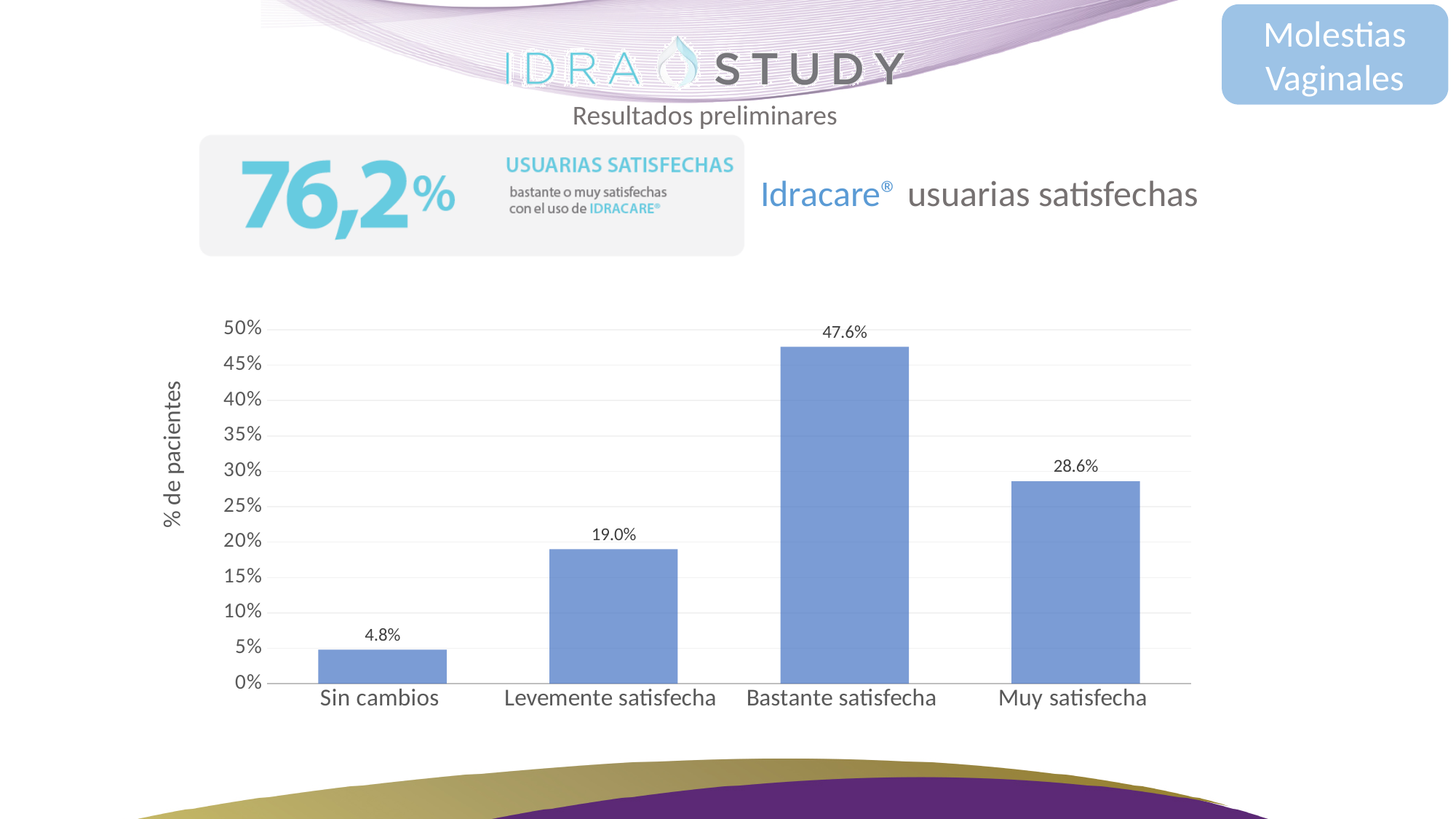
Which category has the highest value? Bastante satisfecha What is the value for Sin cambios? 4.8% What is the label of the vertical axis? % de pacientes What is the value for Bastante satisfecha? 47.6% What kind of chart is shown on the slide? bar chart What is the value for Muy satisfecha? 28.6% What is the difference between the values for Bastante satisfecha and Muy satisfecha? 19.0% Is the value for Muy satisfecha greater or less than 25%? greater What is the value for Levemente satisfecha? 19.0% Which category has the lowest value? Sin cambios Which is larger, the value for Levemente satisfecha or the value for Muy satisfecha? Muy satisfecha How many categories are shown on the x axis? 4